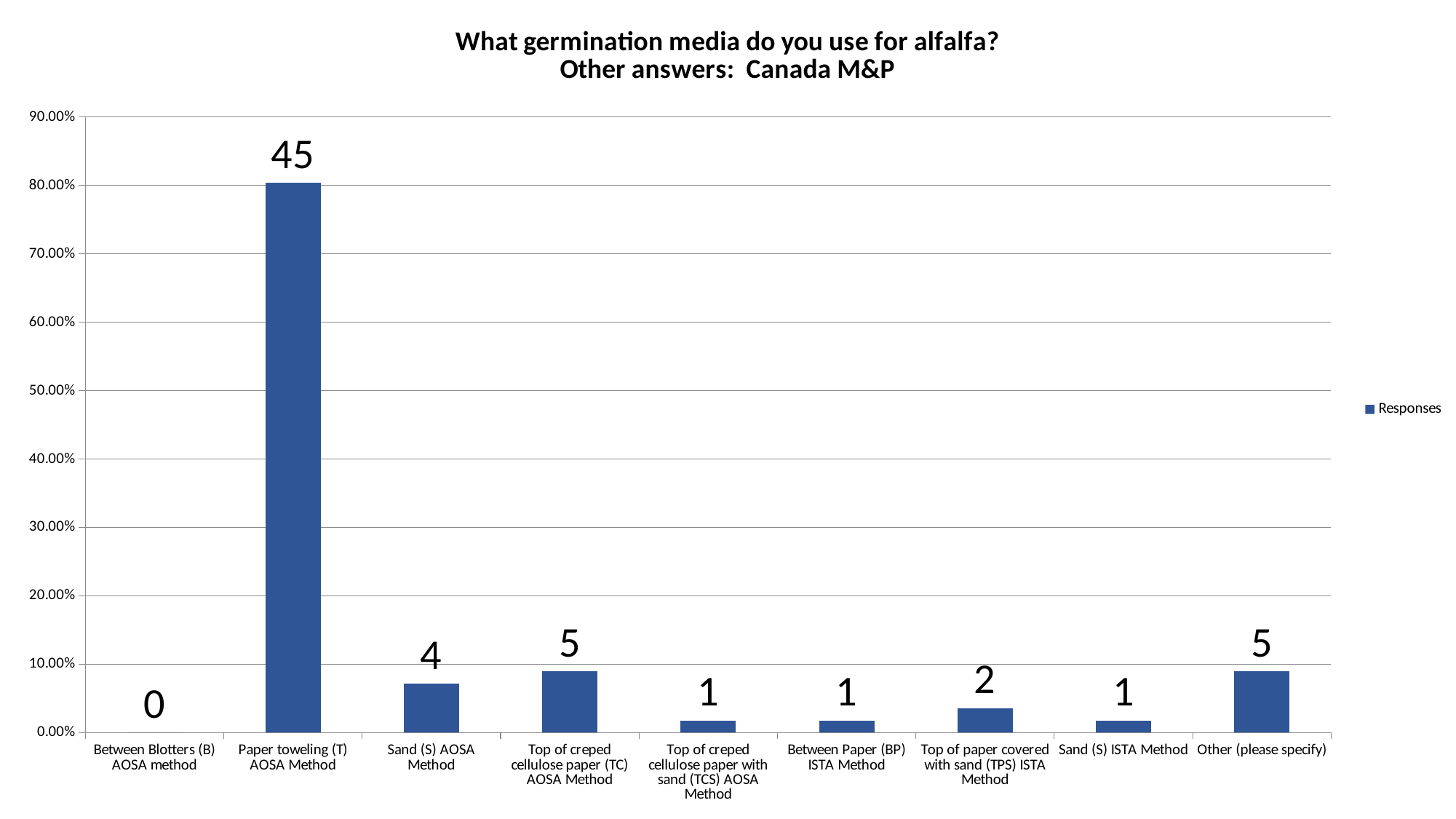
Which has a larger value, Sand (S) AOSA Method or Sand (S) ISTA Method? Sand (S) AOSA Method What is the data label shown for Top of paper covered with sand (TPS) ISTA Method? 2 How many categories are shown on the x axis? 9 What kind of chart is shown on the slide? Bar chart What is the data label shown for Sand (S) AOSA Method? 4 Which category has the lowest value? Between Blotters (B) AOSA method Is the bar for Paper toweling (T) AOSA Method greater or less than 70.00% on the axis? greater How many series does the legend list? 1 Which category has the highest value? Paper toweling (T) AOSA Method What is the difference between the data labels for Paper toweling (T) AOSA Method and Top of creped cellulose paper (TC) AOSA Method? 40 What is the data label shown for Paper toweling (T) AOSA Method? 45 What is the data label shown for Between Blotters (B) AOSA method? 0